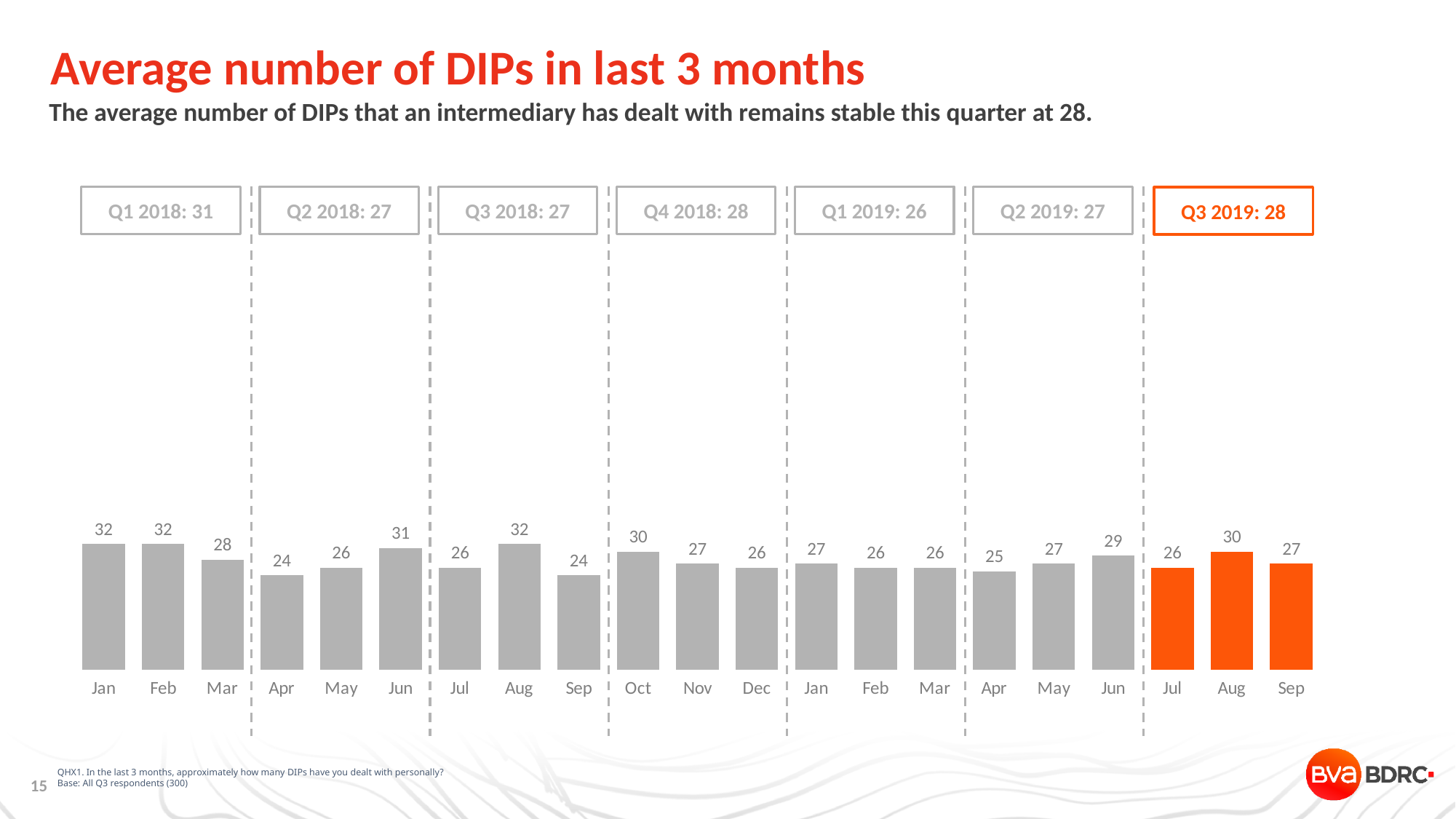
How many monthly bars are plotted on the chart? 21 What is the highest monthly value shown on the chart? 32 What quarterly average is shown in the box for Q3 2019? 28 What type of chart is shown on the slide? bar chart What is the lowest monthly value shown on the chart? 24 What is the difference between the value for Aug in Q3 2018 and the value for Sep in Q3 2018? 8 Which is larger: the value for Jun in Q2 2019 or the value for Jul in Q3 2019? Jun in Q2 2019 What is the value for Oct in the Q4 2018 section of the chart? 30 Which quarter's bars are coloured orange rather than grey? Q3 2019 What is the value for Apr in the Q2 2019 section of the chart? 25 What is the value for Aug in the Q3 2019 section of the chart? 30 What is the value for Jun in the Q2 2018 section of the chart? 31